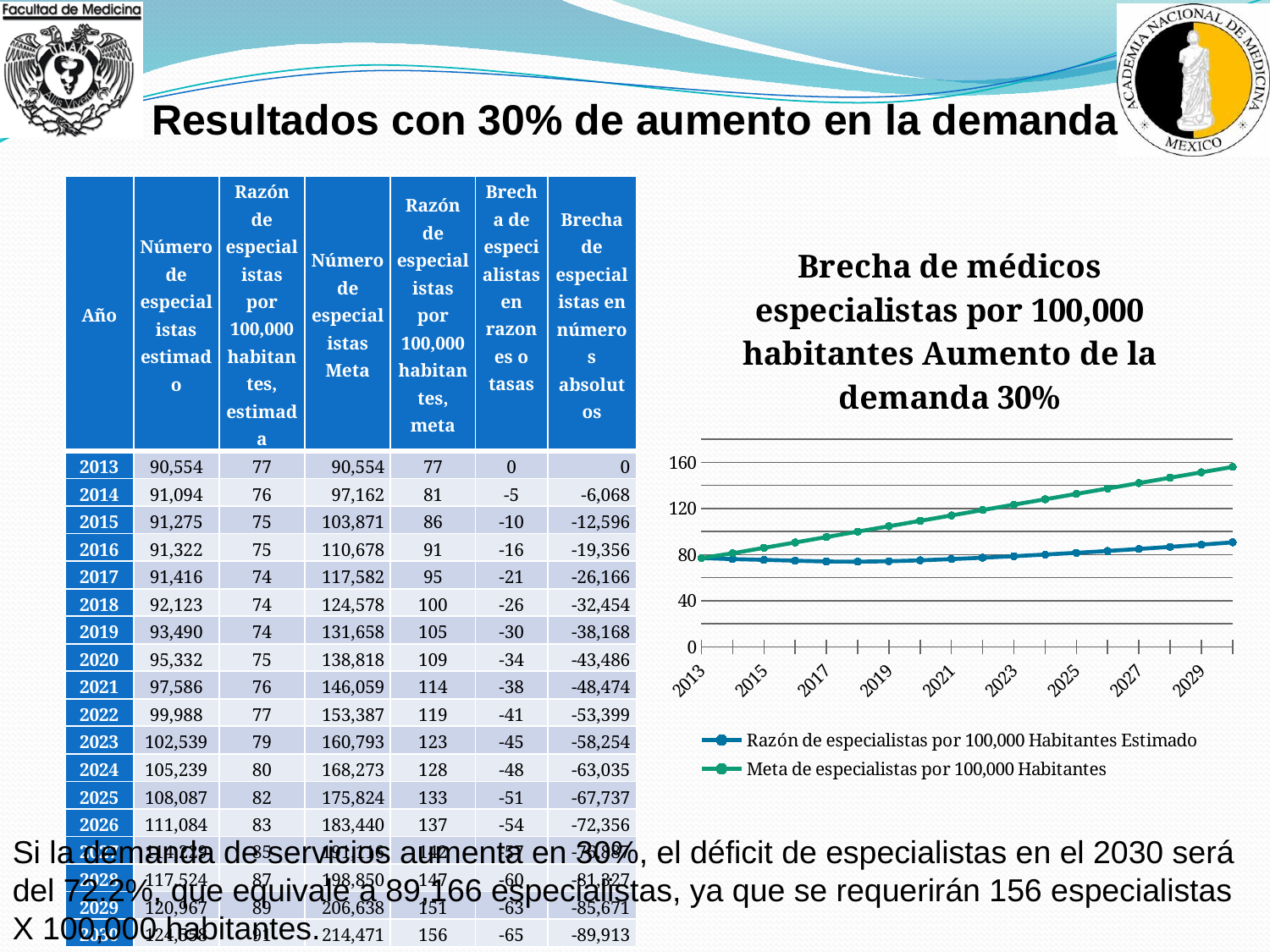
Is the value of 'Meta de especialistas por 100,000 Habitantes' in 2017 greater or less than 80? greater What is the title of the chart? Brecha de médicos especialistas por 100,000 habitantes Aumento de la demanda 30% How many year labels are shown on the x axis of the chart? 9 How many series does the chart legend list? 2 Is the value of 'Razón de especialistas por 100,000 Habitantes Estimado' in 2029 greater or less than 80? greater Is the value of 'Razón de especialistas por 100,000 Habitantes Estimado' in 2029 greater or less than 120? less Which series is shown in the lighter green line in the chart? Meta de especialistas por 100,000 Habitantes In 2025, which series has the larger value: 'Meta de especialistas por 100,000 Habitantes' or 'Razón de especialistas por 100,000 Habitantes Estimado'? Meta de especialistas por 100,000 Habitantes Does the 'Meta de especialistas por 100,000 Habitantes' line rise or fall from 2013 to 2029? rise What kind of chart is shown on the slide? line chart